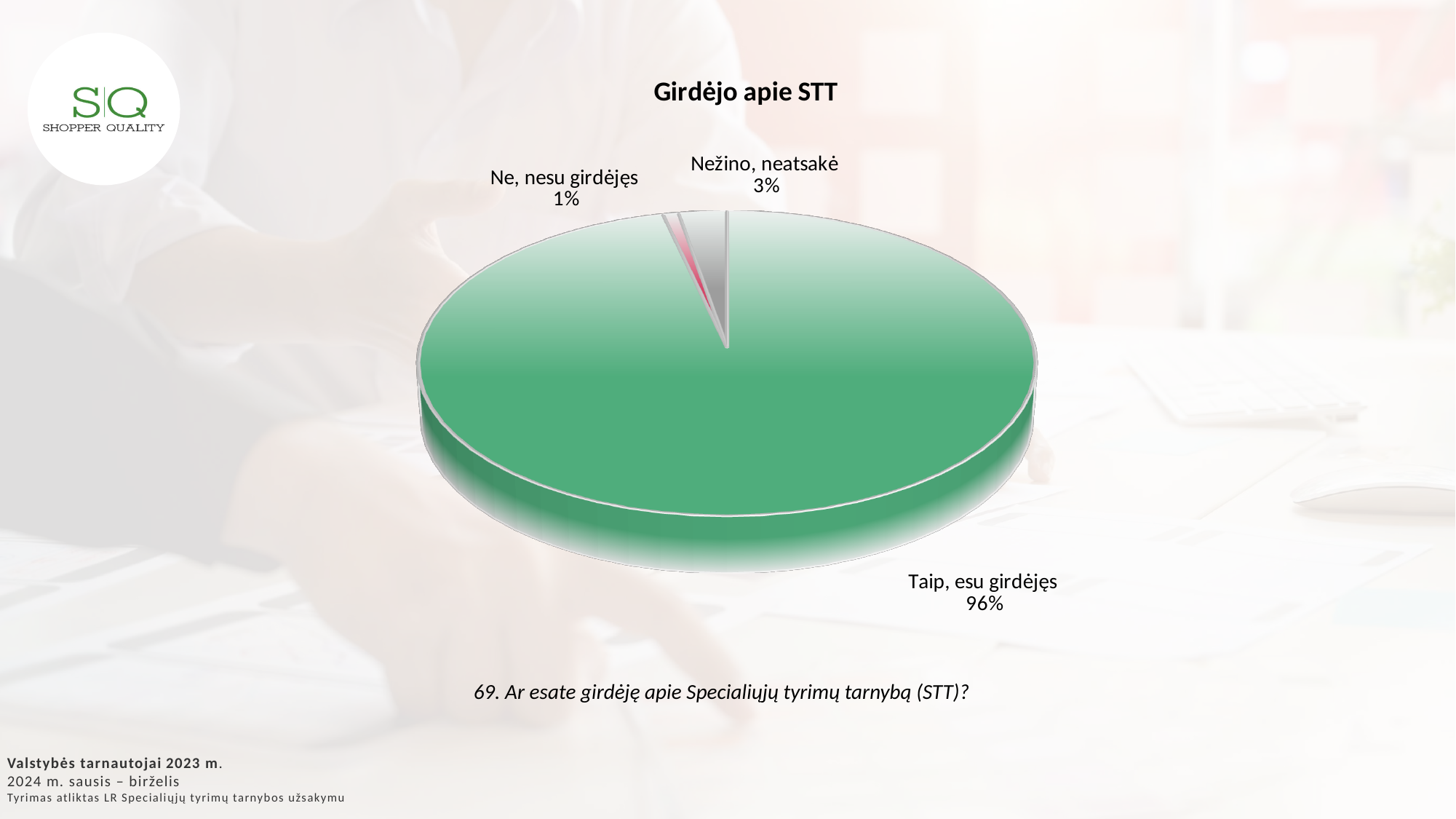
What percentage of respondents answered "Ne, nesu girdėjęs"? 1% Which category has the smallest share of the pie? Ne, nesu girdėjęs What type of chart is shown on the slide? Pie chart What colour is the slice for "Taip, esu girdėjęs"? Green Which is larger: the share for "Nežino, neatsakė" or the share for "Ne, nesu girdėjęs"? Nežino, neatsakė How many categories are shown in the pie chart? 3 What is the difference in percentage points between "Taip, esu girdėjęs" and "Nežino, neatsakė"? 93 What is the title of the chart? Girdėjo apie STT What percentage of respondents answered "Nežino, neatsakė"? 3% What percentage of respondents answered "Taip, esu girdėjęs"? 96% What is the combined share of "Ne, nesu girdėjęs" and "Nežino, neatsakė"? 4% Which category has the largest share of the pie? Taip, esu girdėjęs